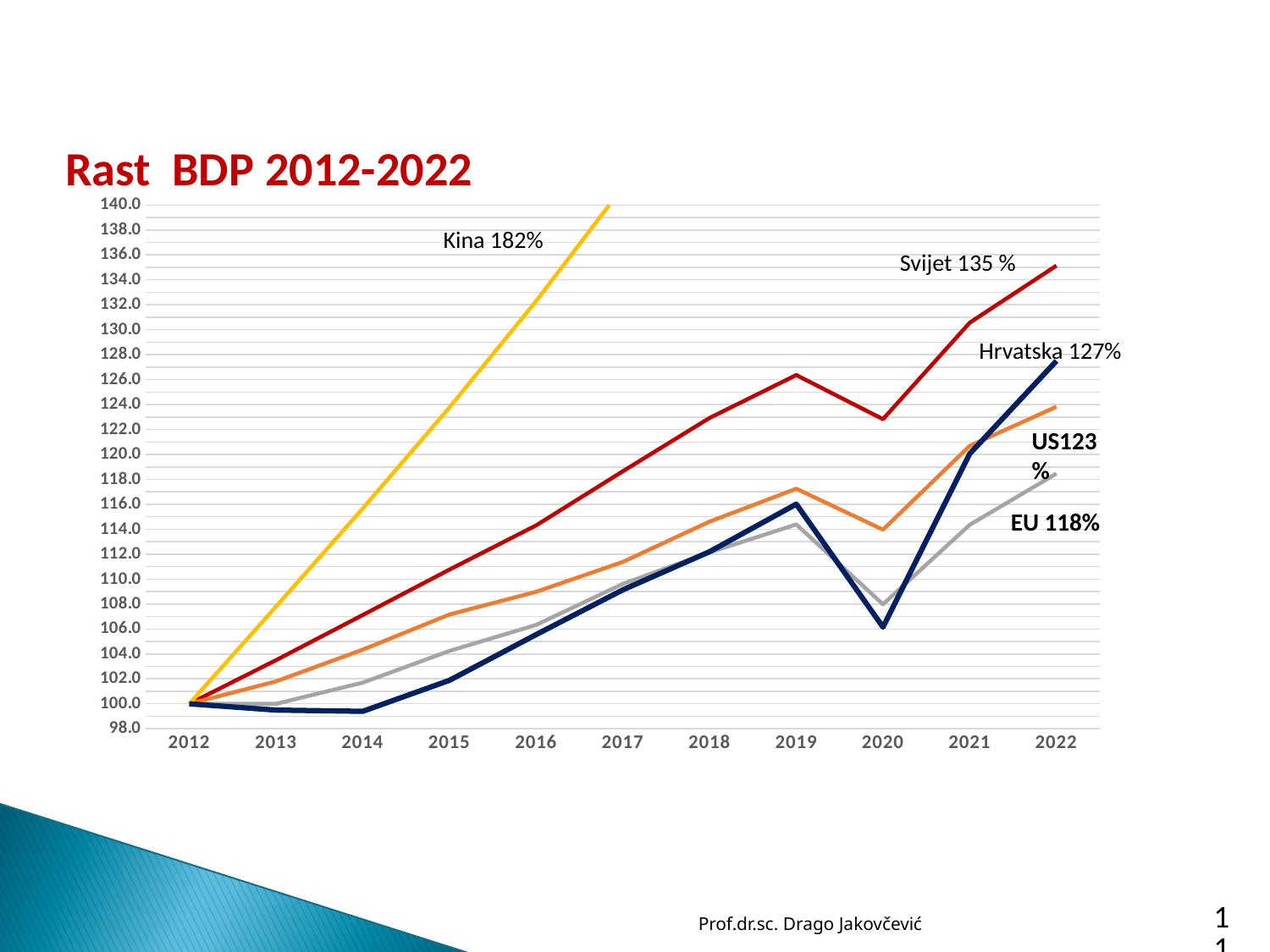
What growth percentage is annotated for Hrvatska on the chart? 127% Which series has the lowest annotated growth percentage? EU How many years are shown on the x axis of the chart? 11 What growth percentage is annotated for EU on the chart? 118% How many lines (series) are plotted on the chart? 5 What kind of chart is shown on the slide? line chart Is the value for Hrvatska in 2020 greater or less than 110? less What growth percentage is annotated for Kina on the chart? 182% What is the title of the chart? Rast BDP 2012-2022 Which series has the highest annotated growth percentage? Kina Does the Hrvatska line rise or fall from 2019 to 2020? fall Is the value for Svijet in 2019 greater or less than 124? greater